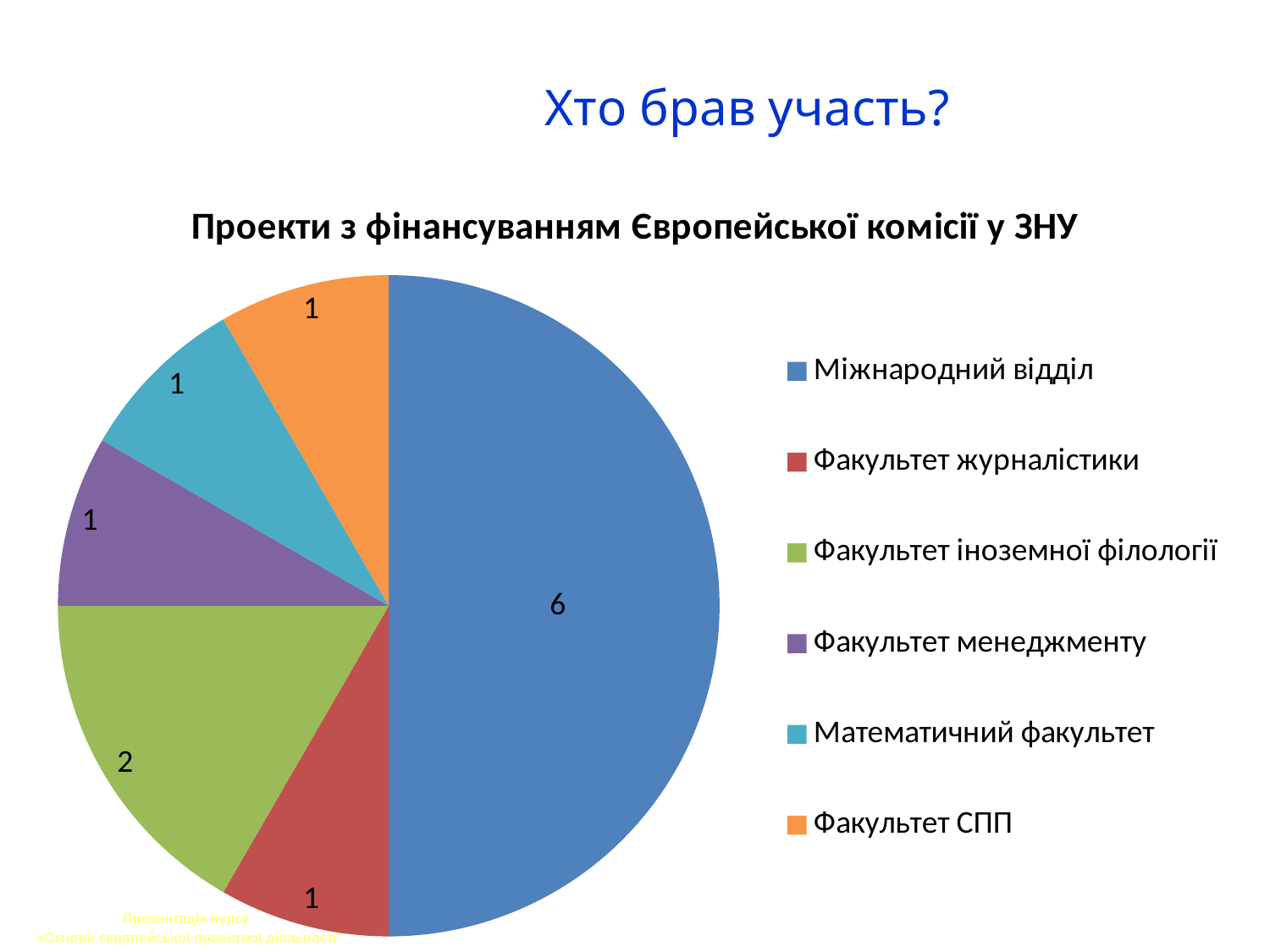
What is the title of the chart? Проекти з фінансуванням Європейської комісії у ЗНУ How many categories (slices) does the pie chart have? 6 What colour is the slice for Міжнародний відділ? Blue What is the value shown for Факультет СПП? 1 How many projects does the chart show for Міжнародний відділ? 6 What type of chart is shown on the slide? Pie chart What is the difference between the value for Міжнародний відділ and the value for Факультет іноземної філології? 4 What is the value shown for Факультет іноземної філології? 2 What is the difference between the value for Міжнародний відділ and the value for Математичний факультет? 5 What share of the pie does Міжнародний відділ represent? 50% Which category has the largest slice of the pie? Міжнародний відділ Which is larger, the value for Факультет іноземної філології or the value for Факультет журналістики? Факультет іноземної філології